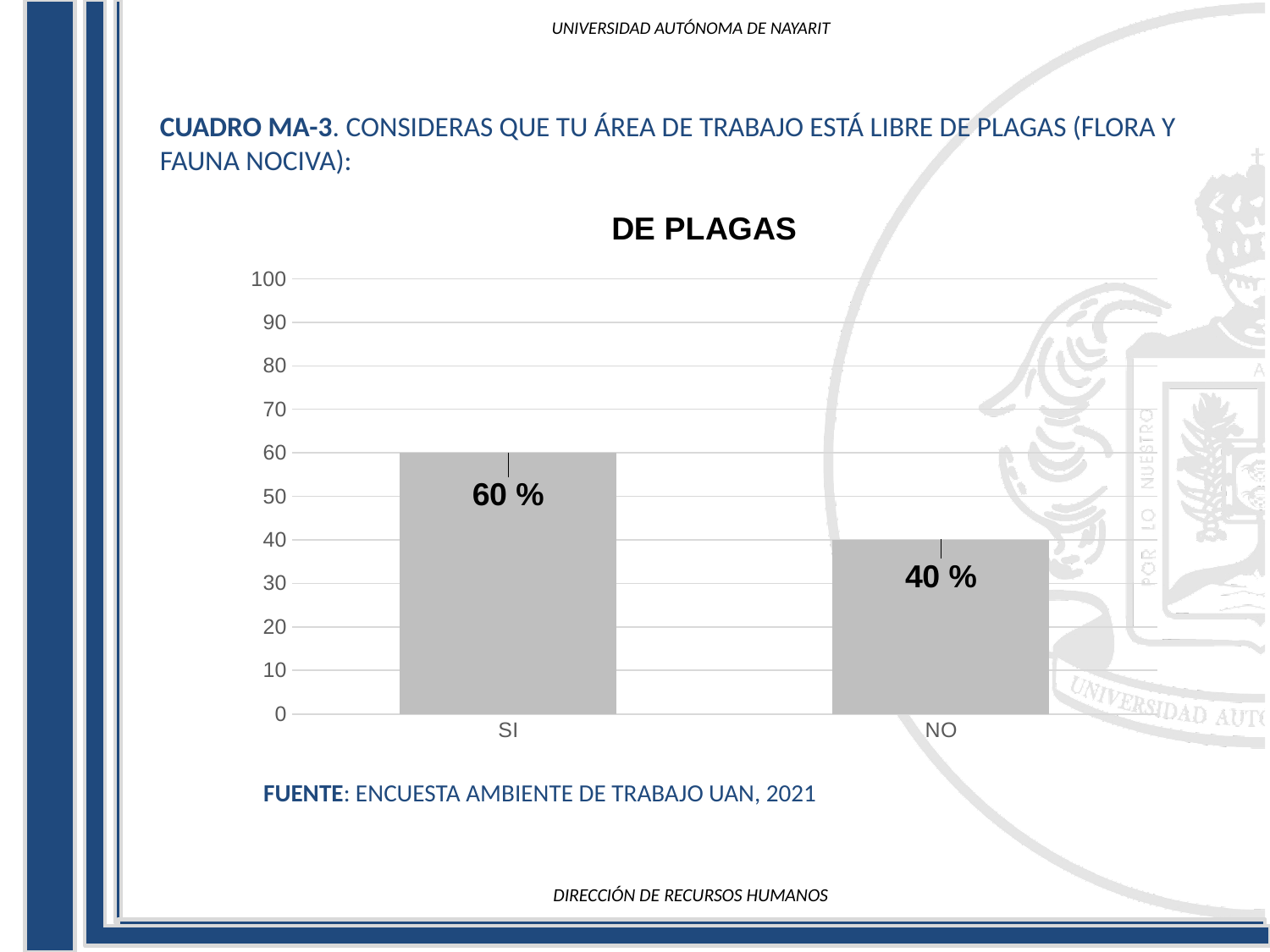
Is the value for NO greater or less than 50? less How many categories are shown on the x axis? 2 What is the title shown above the chart? DE PLAGAS Which category has the lowest value? NO Which is larger, the value for SI or the value for NO? SI What is the value for SI? 60 % Is the value for SI greater or less than 50? greater Do the values rise or fall from SI to NO? fall What kind of chart is shown on the slide? bar chart Which category has the highest value? SI What is the value for NO? 40 % What is the difference between the values for SI and NO? 20 %